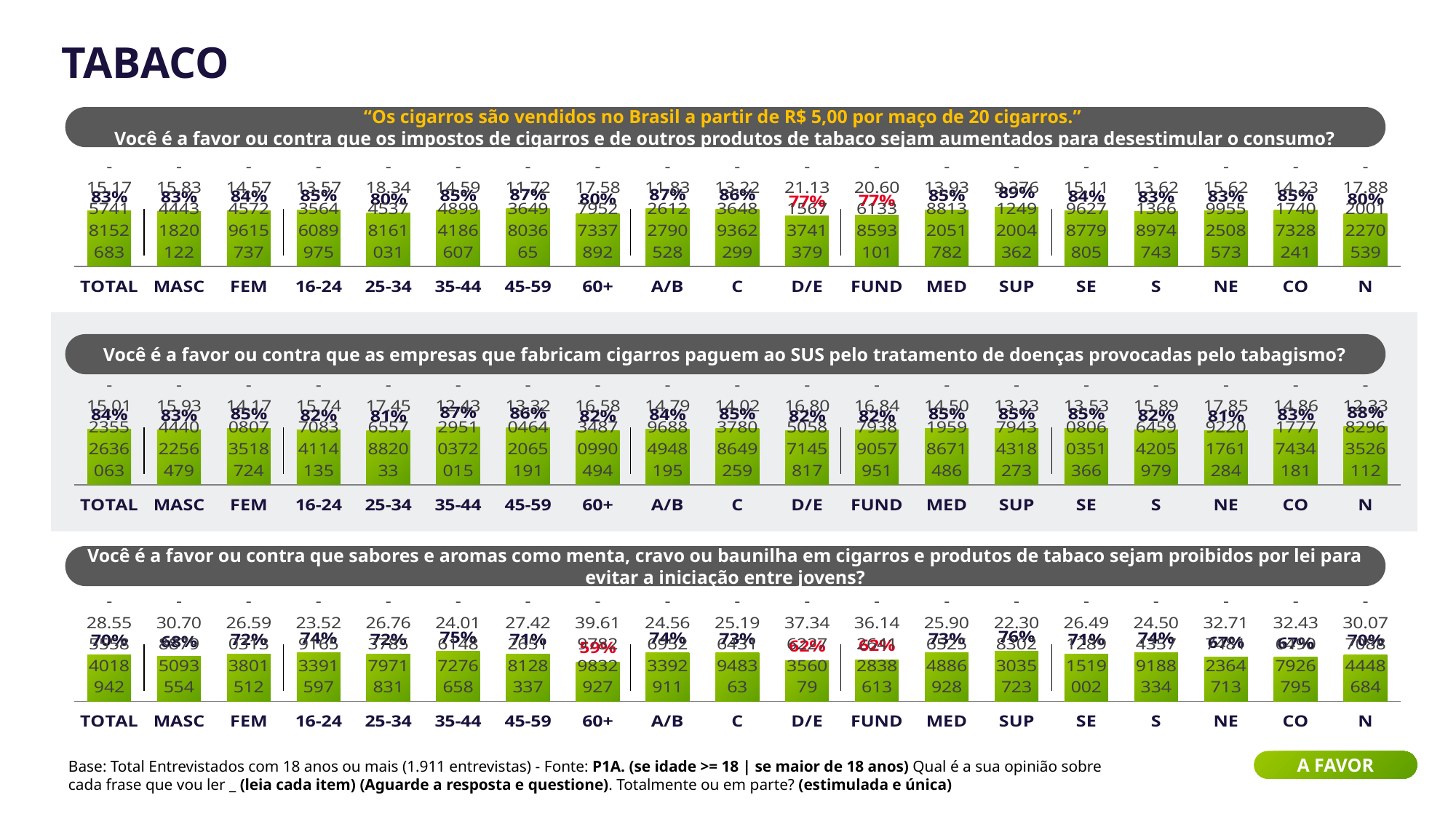
In the top chart (about increasing taxes on cigarettes), what percentage is shown for D/E? 77% In the bottom chart (about banning flavours and aromas), what is the difference between the percentages for SUP and 60+? 17 percentage points In the top chart (about increasing taxes on cigarettes), what percentage is shown for TOTAL? 83% In the bottom chart (about banning flavours and aromas), what percentage is shown for TOTAL? 70% What kind of chart is the middle chart (about companies paying the SUS)? Bar chart What is the title of the slide? TABACO In the middle chart (about companies paying the SUS), what percentage is shown for 35-44? 87% In the top chart (about increasing taxes on cigarettes), which is larger, the percentage for A/B or the percentage for C? A/B In the bottom chart (about banning flavours and aromas), which category has the lowest percentage? 60+ How many categories are shown along the x axis of the bottom chart (about banning flavours and aromas)? 19 In the middle chart (about companies paying the SUS), which category has the highest percentage? N In the top chart (about increasing taxes on cigarettes), which category has the highest percentage? SUP